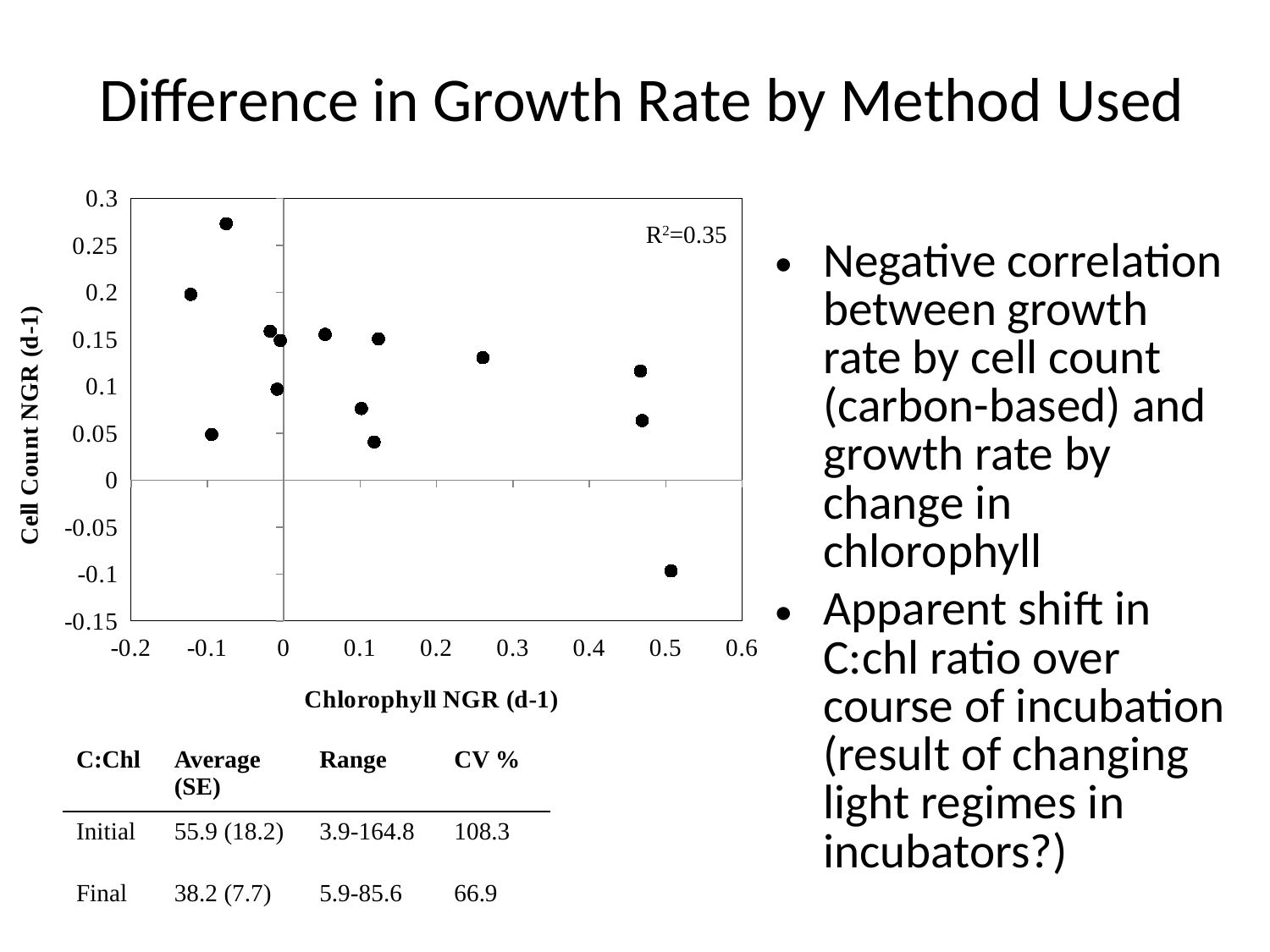
Do the Cell Count NGR values generally rise or fall as Chlorophyll NGR increases along the x axis? fall What is the title of the x axis of the chart? Chlorophyll NGR (d-1) What kind of chart is shown on the slide? scatter plot What is the maximum value shown on the y axis of the chart? 0.3 Is the Cell Count NGR value of the point with the largest Chlorophyll NGR greater or less than 0? less Is the highest Cell Count NGR value plotted greater or less than 0.25? greater Is the Cell Count NGR of the point with the highest Cell Count NGR greater or less than the Cell Count NGR of the point with the largest Chlorophyll NGR? greater How many points on the chart have a Cell Count NGR value below 0? 1 Is the largest Chlorophyll NGR value plotted greater or less than 0.4? greater What is the R-squared value printed on the chart? R²=0.35